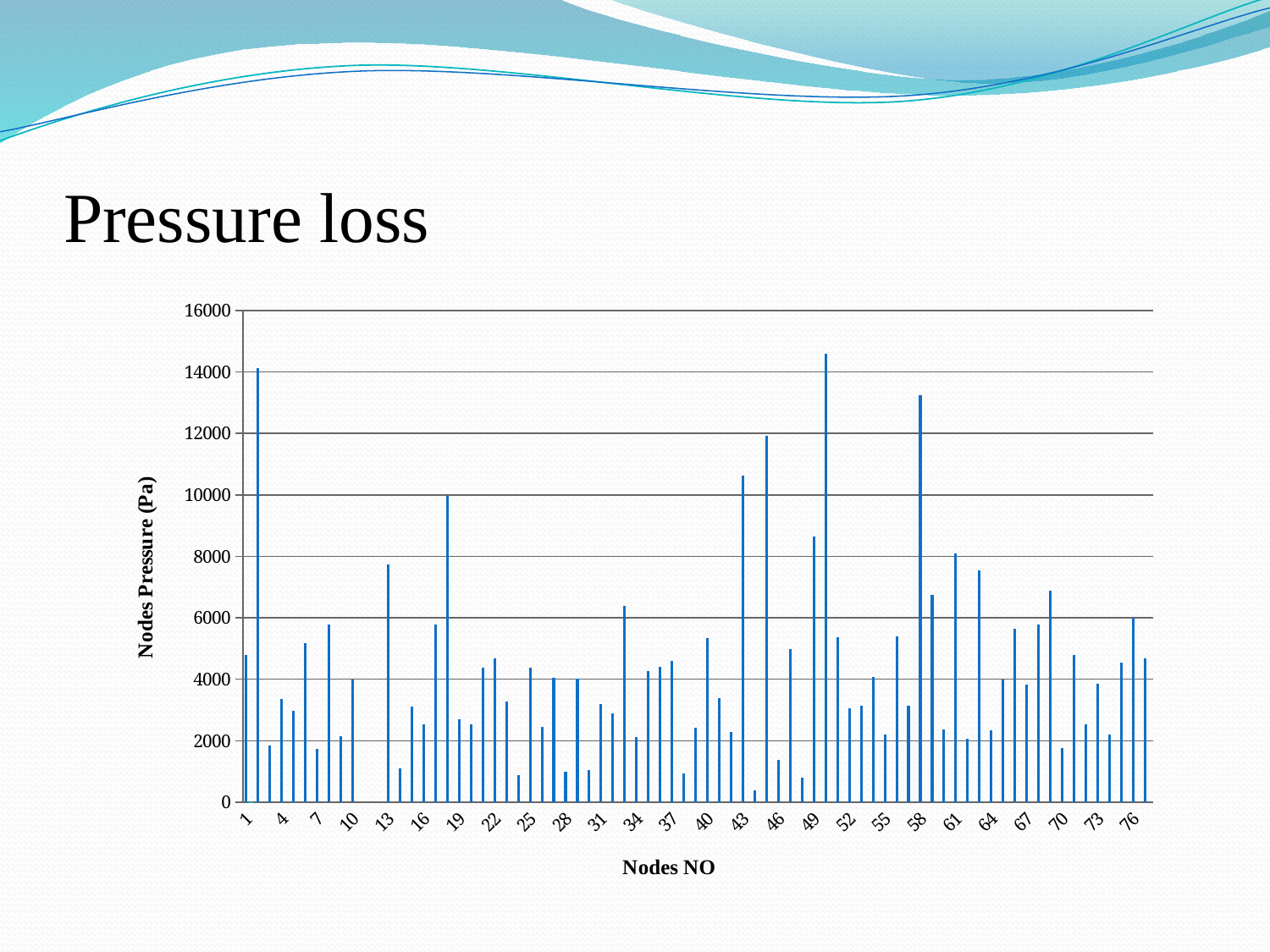
Is the value for node 43 greater or less than 8000? greater Is the value for node 22 greater or less than 6000? less Is the value for node 4 greater or less than 4000? less What kind of chart is shown on the slide? bar chart What is the title of the y axis of the chart? Nodes Pressure (Pa) What is the highest value shown on the y axis of the chart? 16000 What is the title of the x axis of the chart? Nodes NO